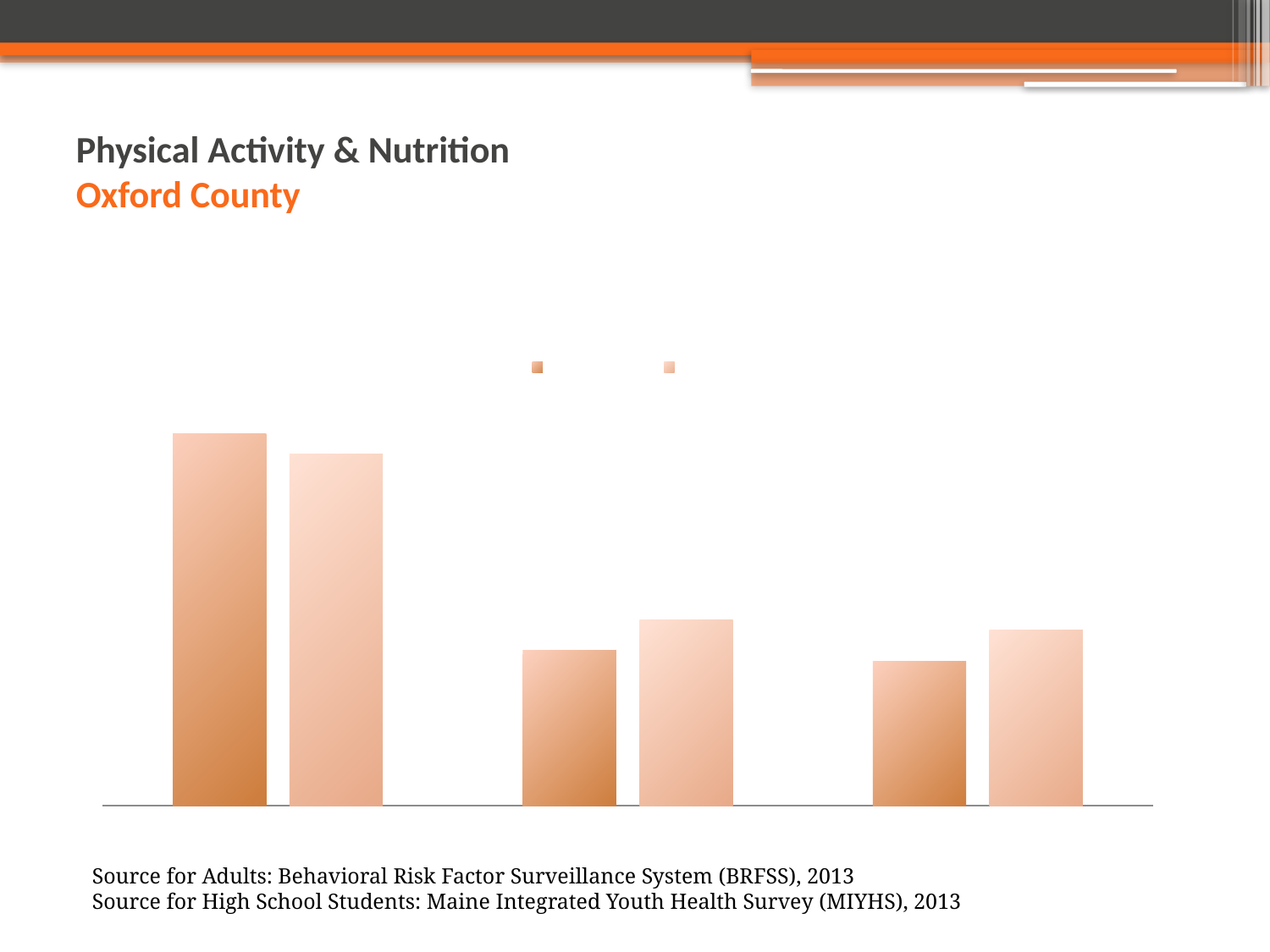
In the leftmost group of bars, which bar is taller, the darker orange bar or the lighter orange bar? the darker orange bar How many series does the chart's legend list? 2 What kind of chart is shown on the slide? bar chart What colours are the two series in the chart? darker orange and lighter orange Does the chart display data labels on its bars? No Which group of bars is the tallest: the left, middle, or right group? left In the middle group of bars, which bar is taller, the darker orange bar or the lighter orange bar? the lighter orange bar In the rightmost group of bars, which bar is taller, the darker orange bar or the lighter orange bar? the lighter orange bar How many groups of bars are plotted on the chart? 3 Do the darker orange bars rise or fall from the left group to the right group? fall How many bars are plotted on the chart in total? 6